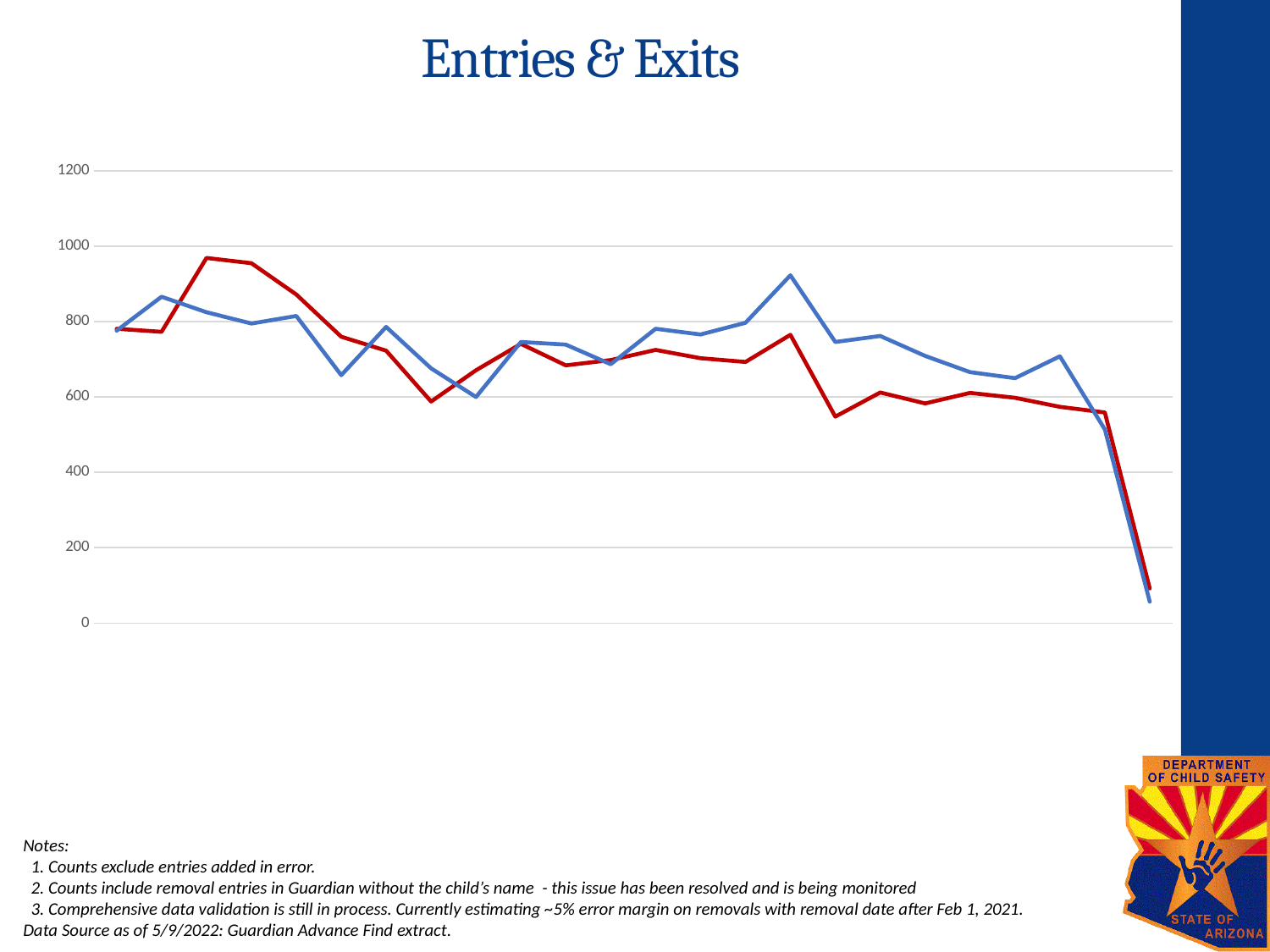
Is the highest point of the blue line greater or less than 800? greater Is the first point of the red line greater or less than 600? greater What kind of chart is shown on the slide? line chart What colours are the two lines on the chart? blue and red What is the highest value shown on the vertical axis? 1200 How many lines are plotted on the chart? 2 Overall, do the values of the blue line rise or fall from the left end of the chart to the right end? fall Overall, do the values of the red line rise or fall from the left end of the chart to the right end? fall What is the title of the chart? Entries & Exits Is the final point of the blue line greater or less than 200? less